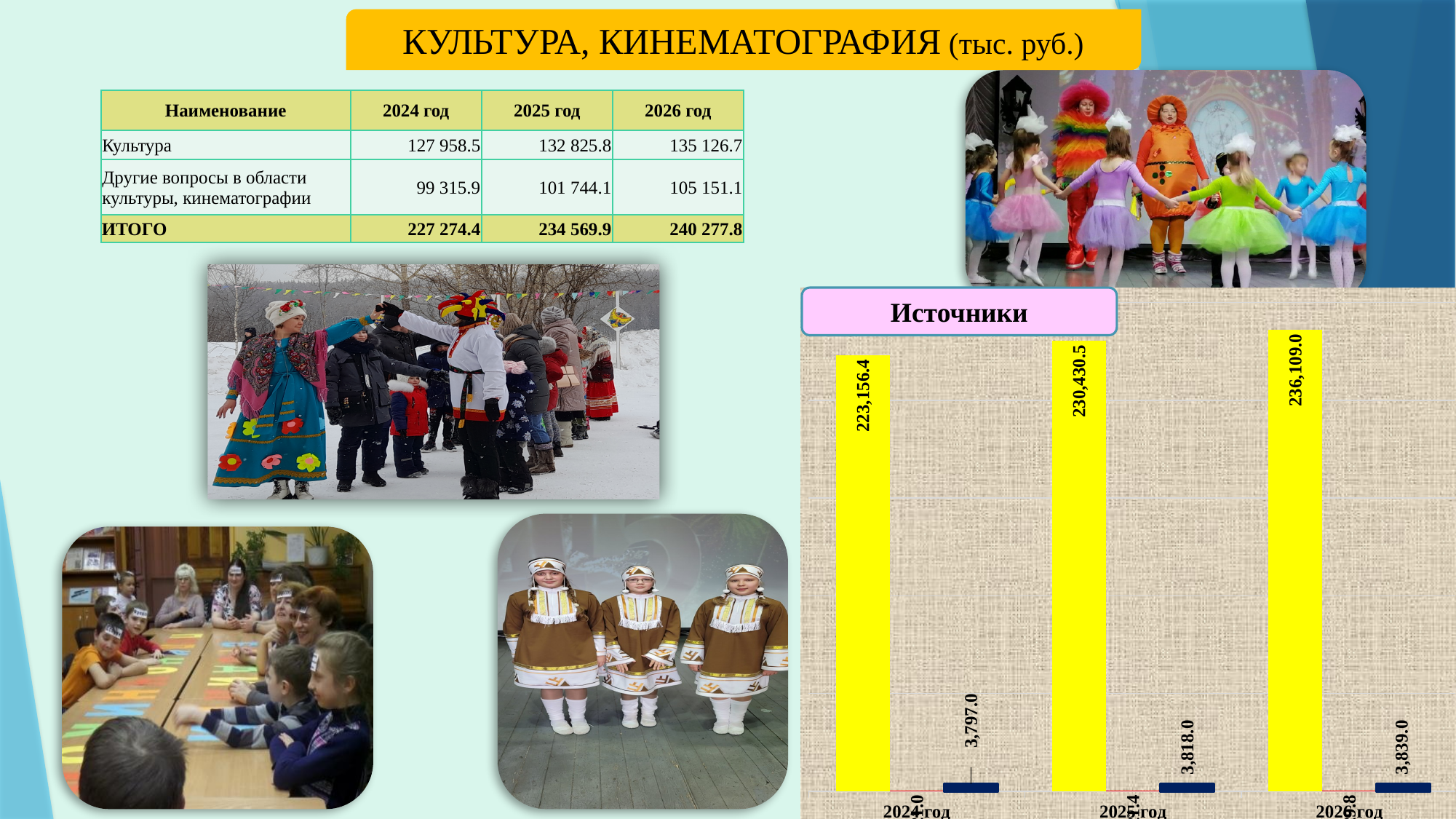
What type of chart is the 'Источники' chart? bar chart In the 'Источники' chart, what is the difference between the yellow bar values for 2026 год and 2024 год? 12,952.6 In the 'Источники' chart, what is the value of the yellow bar for 2024 год? 223,156.4 In the 'Источники' chart, what is the value of the dark blue bar for 2026 год? 3,839.0 In the 'Источники' chart, is the yellow bar for 2025 год larger or smaller than the yellow bar for 2024 год? larger In the 'Источники' chart, which year has the lowest yellow bar? 2024 год In the 'Источники' chart, what is the difference between the dark blue bar values for 2026 год and 2024 год? 42.0 In the 'Источники' chart, what is the value of the dark blue bar for 2025 год? 3,818.0 In the 'Источники' chart, do the yellow bar values rise or fall from 2024 год to 2026 год? rise In the 'Источники' chart, which year has the highest yellow bar? 2026 год How many year categories are shown on the x axis of the 'Источники' chart? 3 In the 'Источники' chart, what is the value of the yellow bar for 2026 год? 236,109.0